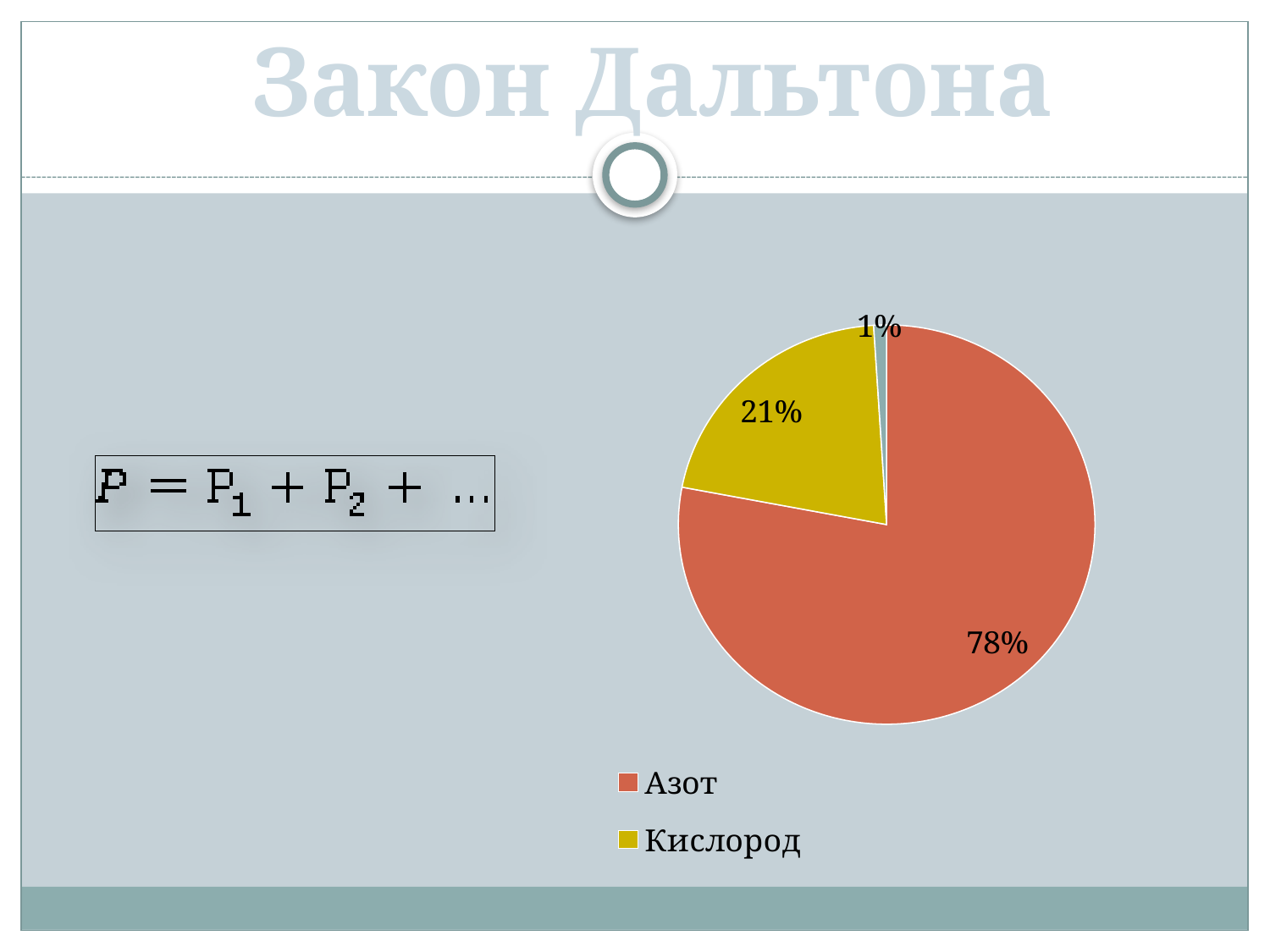
How many slices does the pie chart have? 3 What is the value shown for the Кислород slice? 21% Which legend category has the largest slice of the pie? Азот What colour is the Кислород slice in the pie chart? yellow What is the difference in percentage points between the Азот slice and the Кислород slice? 57 percentage points What share of the pie does Азот take? 78% What is the value shown for the Азот slice? 78% Which is larger, the slice for Азот or the slice for Кислород? Азот Which of the two legend categories, Азот or Кислород, has the smaller slice? Кислород What kind of chart is shown on the slide? pie chart What share of the pie does Кислород take? 21% How many entries does the legend list? 2